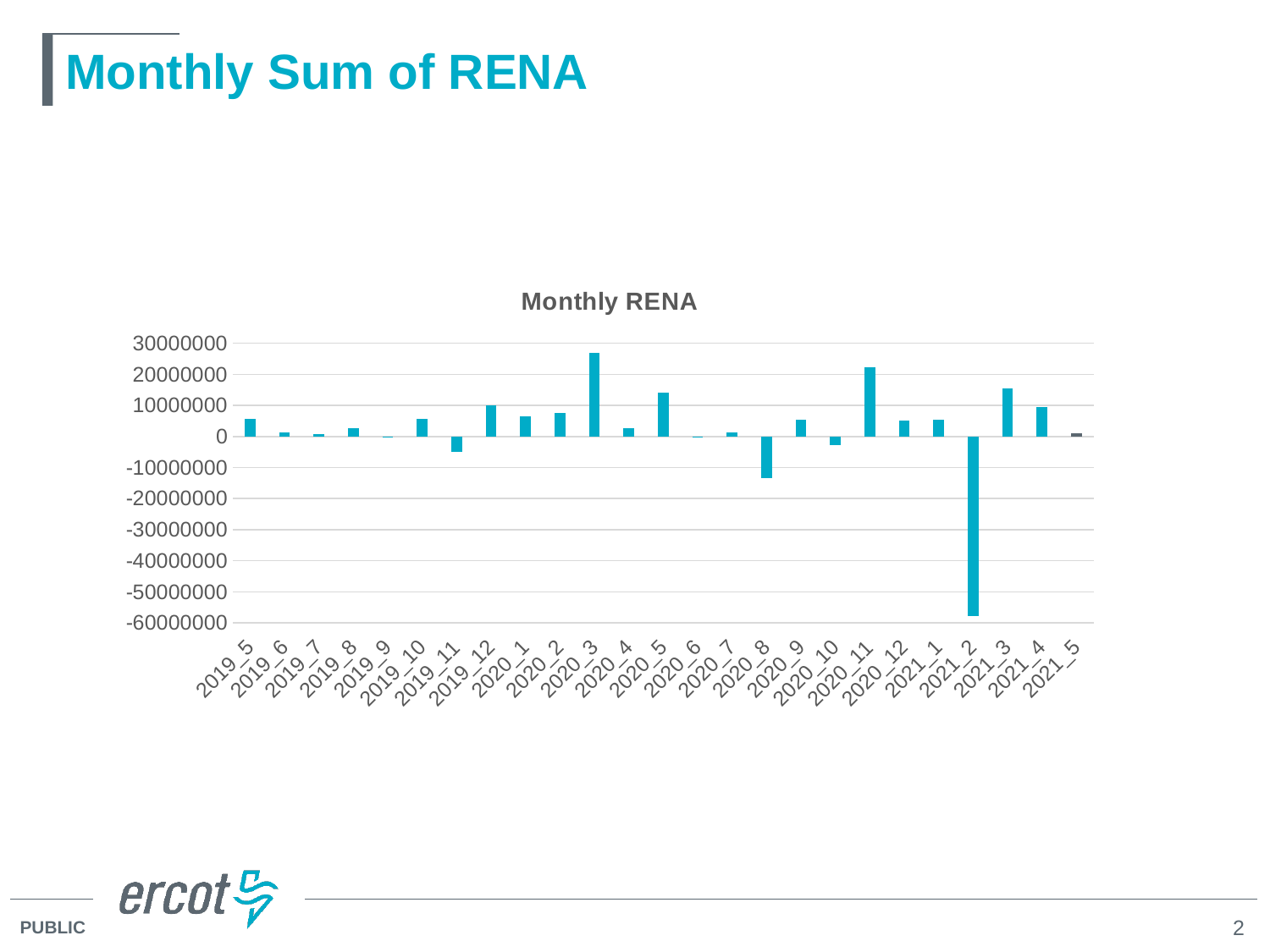
Which is larger, the value for 2020_3 or the value for 2020_11? 2020_3 Which month has the highest Monthly RENA value? 2020_3 Which is lower, the value for 2020_8 or the value for 2021_2? 2021_2 What is the title of the chart? Monthly RENA Which month has the lowest Monthly RENA value? 2021_2 Is the value for 2020_3 greater or less than 20000000? greater Is the value for 2021_2 greater or less than -50000000? less What kind of chart is shown on the slide? Bar chart How many months (categories) are plotted on the x axis? 25 Is the value for 2019_11 greater or less than 0? less